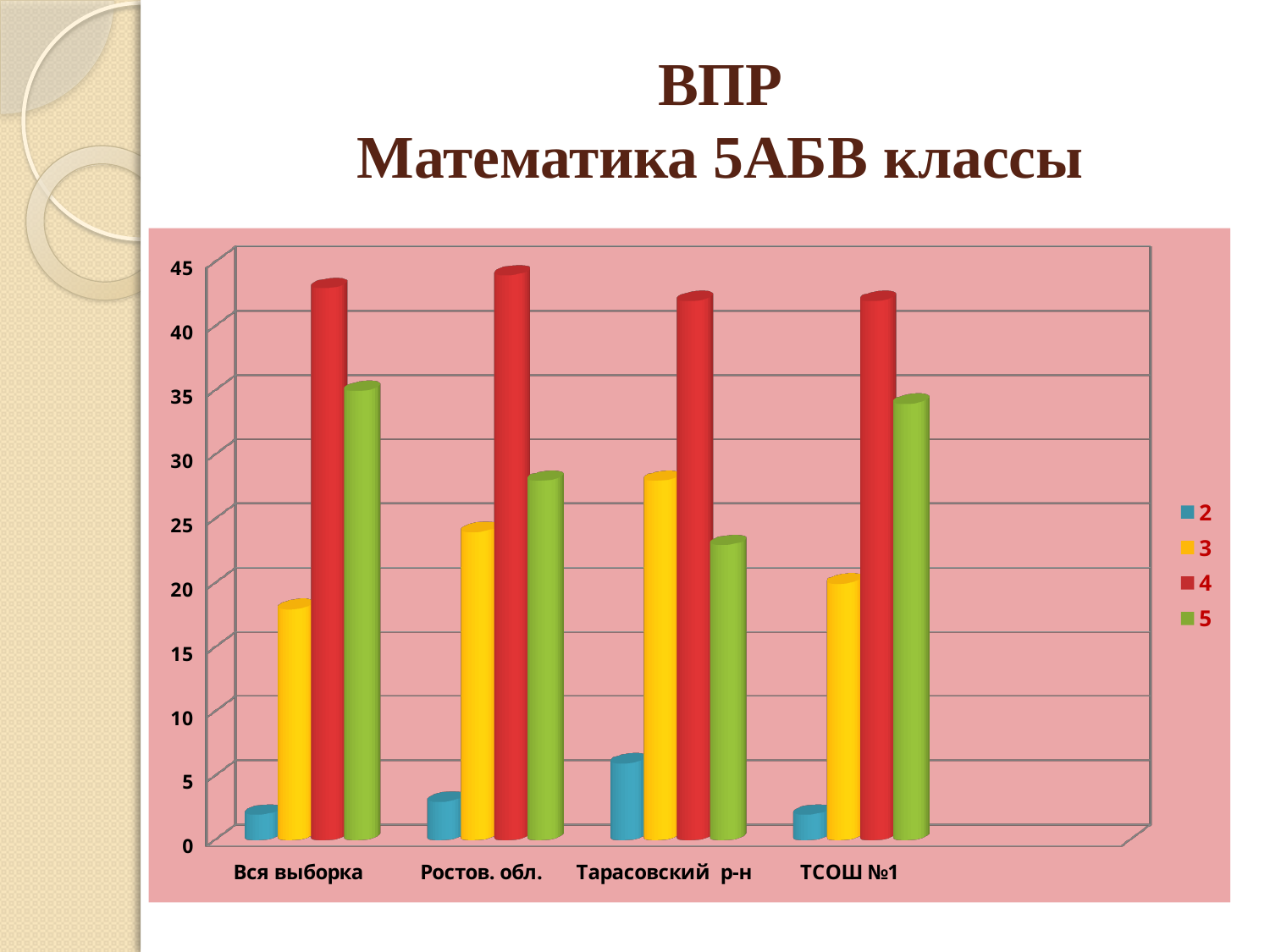
Is the value of series 2 for Тарасовский р-н greater or less than 10? less How many categories are shown on the x axis of the chart? 4 Which entries are listed in the chart's legend? 2, 3, 4, 5 Is the value of series 3 for Вся выборка greater or less than 20? less What kind of chart is shown on the slide? bar chart Is the value of series 4 for Тарасовский р-н greater or less than 40? greater How many series does the legend list? 4 Which series has the lowest value for ТСОШ №1? 2 Which category has the highest value for series 2? Тарасовский р-н Which is larger: the value of series 5 for Вся выборка or for Тарасовский р-н? Вся выборка Which is larger: the value of series 3 for Тарасовский р-н or for Ростов. обл.? Тарасовский р-н